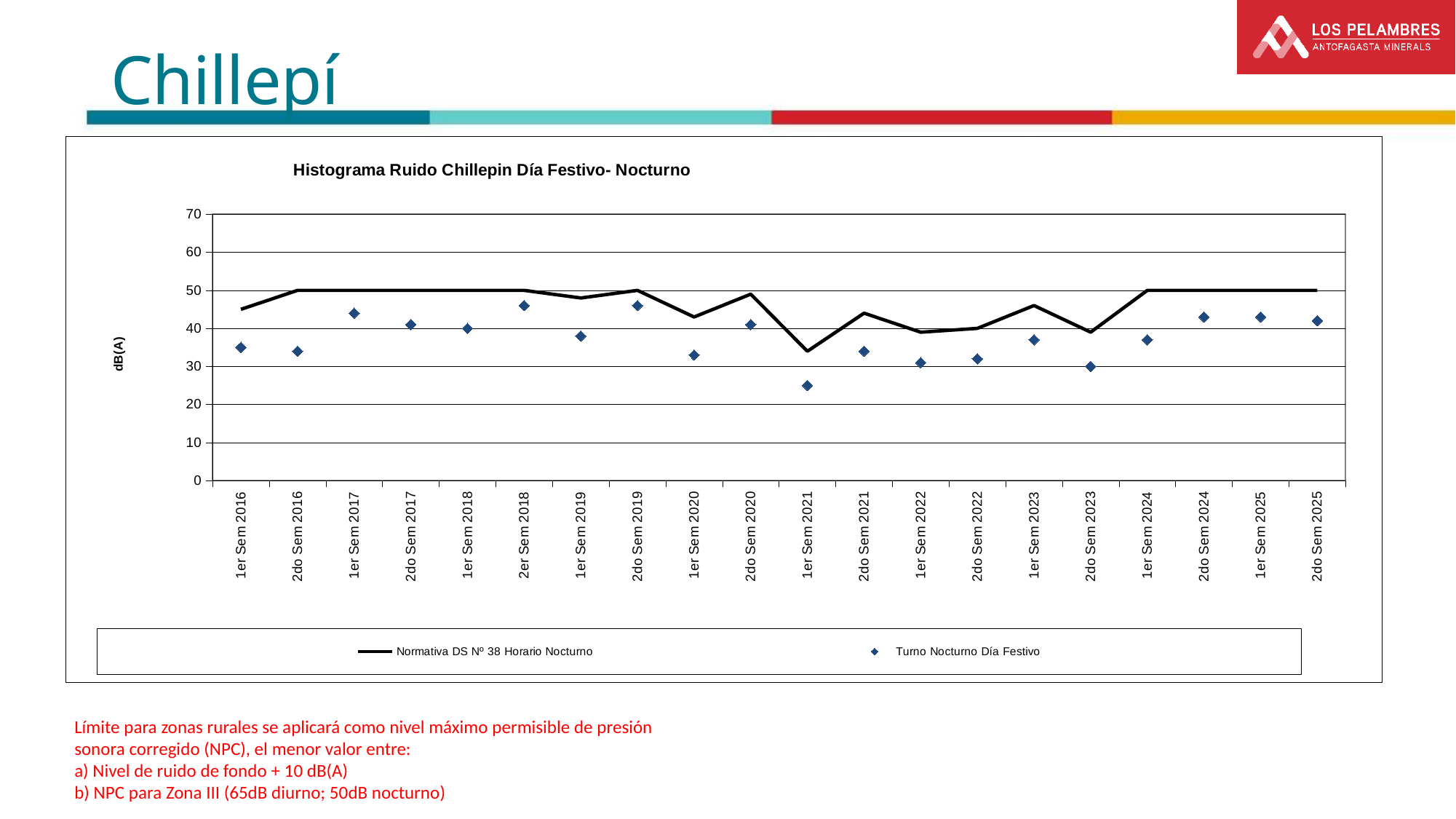
Does the Turno Nocturno Día Festivo value rise or fall from 1er Sem 2024 to 2do Sem 2024? rise In which period is the Turno Nocturno Día Festivo value lowest? 1er Sem 2021 Which is larger for Turno Nocturno Día Festivo: 2do Sem 2016 or 1er Sem 2017? 1er Sem 2017 Is the Turno Nocturno Día Festivo value for 1er Sem 2021 greater or less than 30? less In which period is the Normativa DS Nº 38 Horario Nocturno value lowest? 1er Sem 2021 Is the Normativa DS Nº 38 Horario Nocturno value for 2do Sem 2020 greater or less than 40? greater How many series does the legend list? 2 What is the title of the chart? Histograma Ruido Chillepin Día Festivo- Nocturno Is the Turno Nocturno Día Festivo value for 1er Sem 2017 greater or less than 40? greater What is the label of the y axis? dB(A) What kind of chart is shown on the slide? Line chart How many periods are shown on the x axis? 20